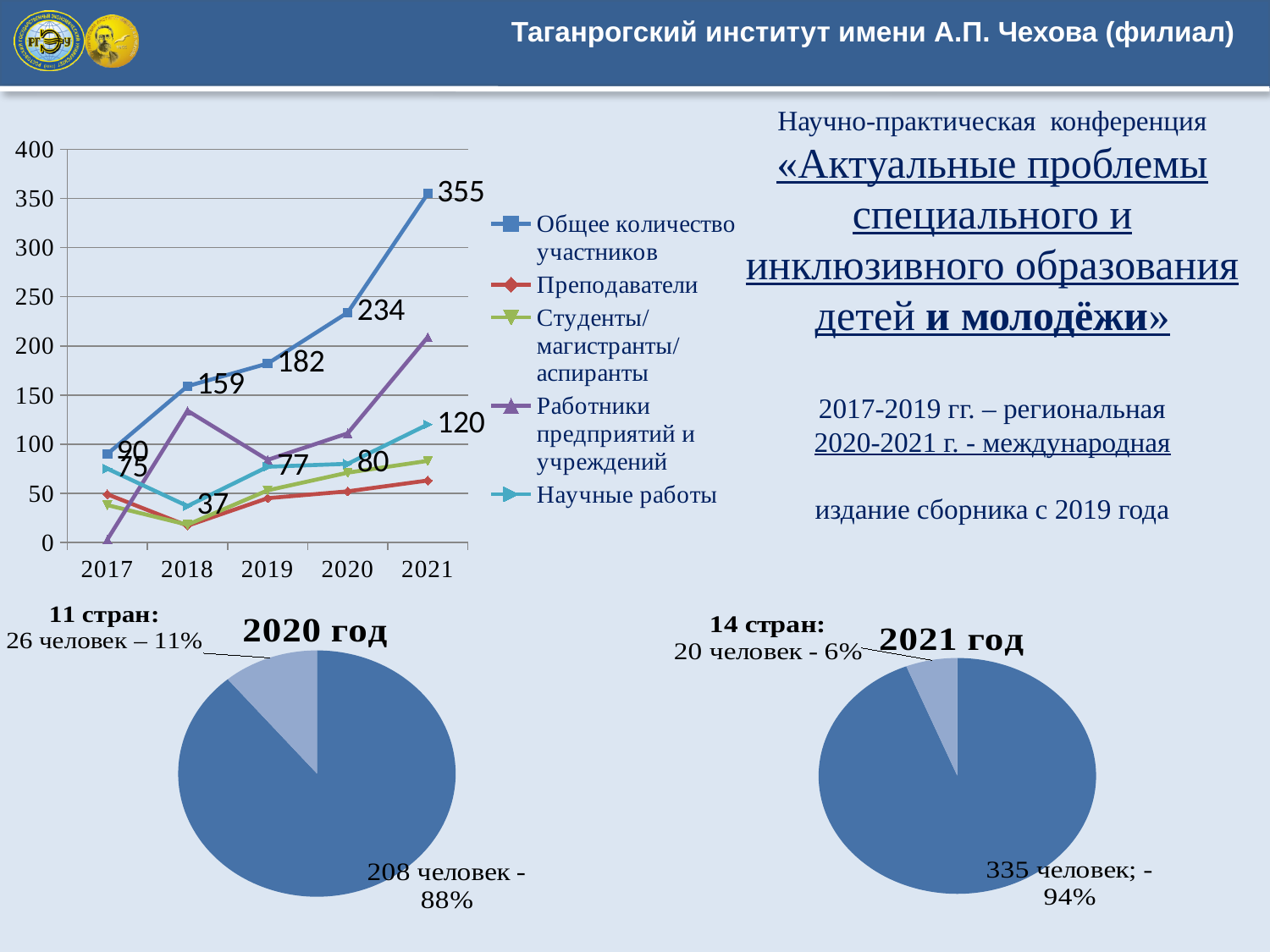
On the line chart, in which year is Общее количество участников highest? 2021 How many years are shown on the x axis of the line chart? 5 On the line chart, what is the value of Научные работы in 2018? 37 How many series does the legend of the line chart list? 5 In the pie chart titled 2021 год, what share does the slice for 20 человек have? 6% On the line chart, in which year is Научные работы lowest? 2018 On the line chart, what is the value of Научные работы in 2021? 120 On the line chart, what is the difference between Общее количество участников in 2021 and in 2020? 121 On the line chart, does Общее количество участников rise or fall from 2017 to 2021? rise On the line chart, what is the value of Общее количество участников in 2018? 159 In the pie chart titled 2020 год, what share does the slice for 208 человек have? 88% On the line chart, what is the value of Общее количество участников in 2021? 355